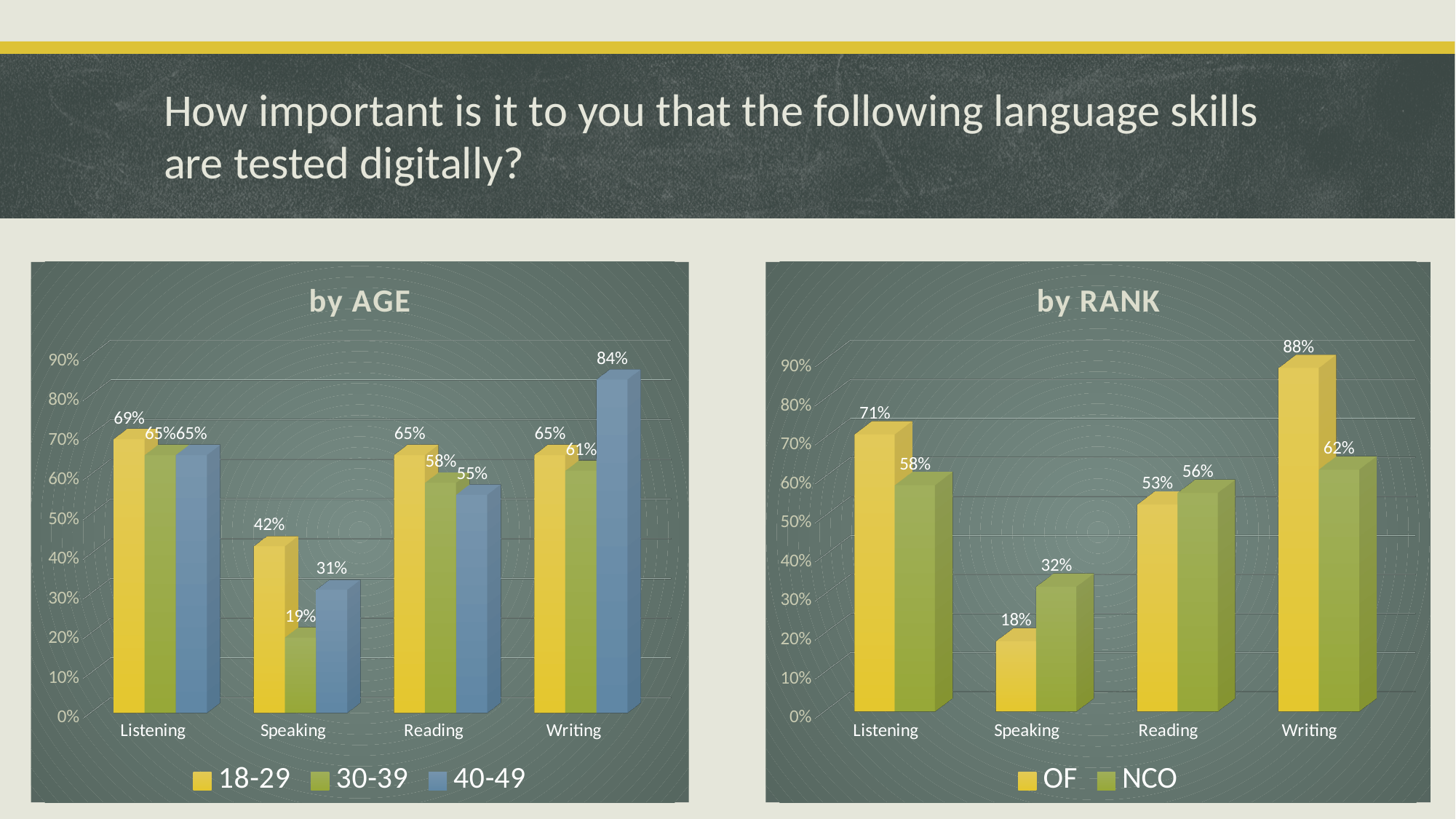
In the 'by RANK' chart, what is the difference between OF and NCO for Writing? 26% In the 'by AGE' chart, which skill has the lowest value for the 18-29 group? Speaking In the 'by AGE' chart, how many skill categories are shown on the x axis? 4 What type of chart is the 'by RANK' chart? Bar chart In the 'by RANK' chart, which is larger for Reading, OF or NCO? NCO In the 'by RANK' chart, which skill has the highest value for OF? Writing In the 'by AGE' chart, what is the value for the 30-39 group for Speaking? 19% In the 'by RANK' chart, what is the value for OF for Listening? 71% In the 'by AGE' chart, what is the value for the 40-49 group for Writing? 84% In the 'by AGE' chart, how many series does the legend list? 3 In the 'by RANK' chart, what are the two legend entries? OF and NCO In the 'by AGE' chart, what is the difference between the 18-29 and 30-39 values for Speaking? 23%